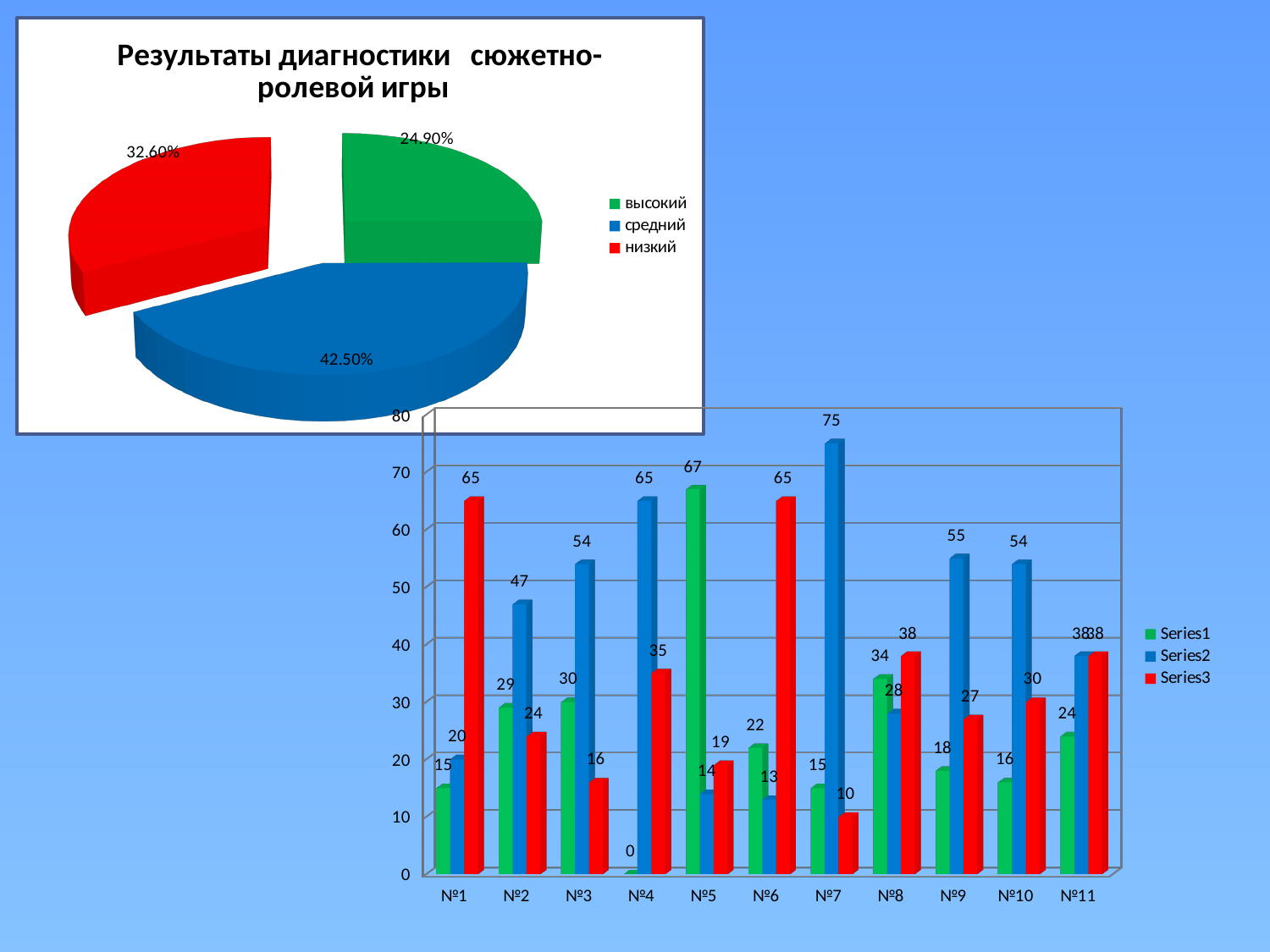
In the bar chart in the bottom right of the slide, what is the value of Series2 for №7? 75 In the pie chart titled 'Результаты диагностики сюжетно-ролевой игры', what is the difference between the 'низкий' and 'высокий' shares? 7.70% In the bar chart in the bottom right of the slide, what is the difference between the Series3 and Series1 values for №1? 50 In the bar chart in the bottom right of the slide, which is larger for №9: Series2 or Series3? Series2 In the pie chart titled 'Результаты диагностики сюжетно-ролевой игры', which category has the smallest slice? высокий In the bar chart in the bottom right of the slide, which category has the lowest Series3 value? №7 In the bar chart in the bottom right of the slide, which category has the highest Series1 value? №5 In the pie chart titled 'Результаты диагностики сюжетно-ролевой игры', what share does the 'средний' slice have? 42.50% What kind of chart is the chart in the bottom right of the slide? bar chart In the bar chart in the bottom right of the slide, what is the value of Series1 for №4? 0 How many series does the legend of the bar chart in the bottom right of the slide list? 3 How many categories does the legend of the pie chart titled 'Результаты диагностики сюжетно-ролевой игры' list? 3